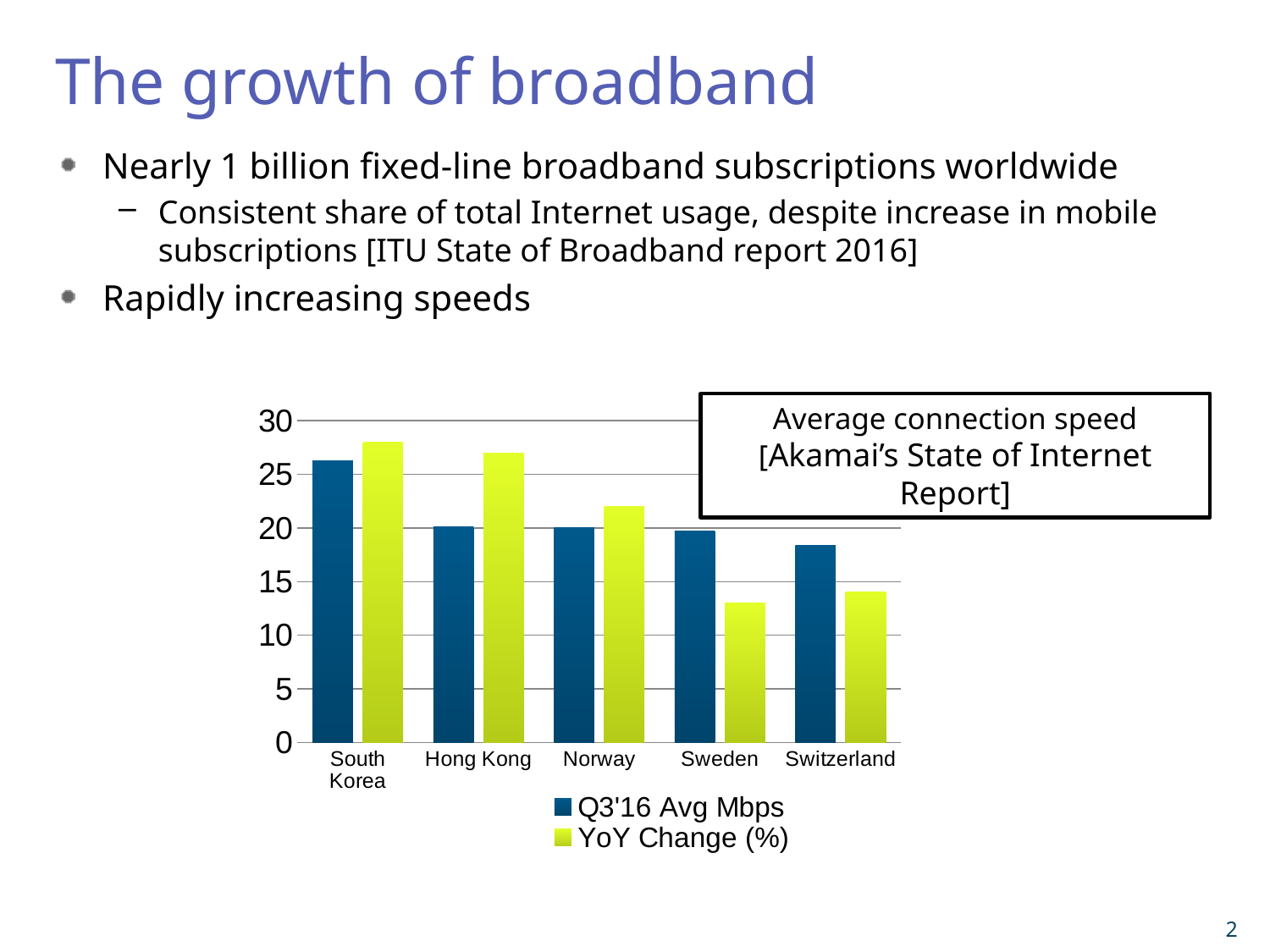
Is the YoY Change (%) value for Hong Kong greater or less than 25? greater What are the two series named in the chart's legend? Q3'16 Avg Mbps and YoY Change (%) Is the Q3'16 Avg Mbps value for South Korea greater or less than 25? greater What is the title shown in the box on the chart? Average connection speed [Akamai's State of Internet Report] Is the YoY Change (%) value for Sweden greater or less than 15? less Do the Q3'16 Avg Mbps values rise or fall from South Korea to Switzerland along the x axis? fall Which country has the lowest Q3'16 Avg Mbps value? Switzerland Which country has the highest Q3'16 Avg Mbps value? South Korea What kind of chart is shown on the slide? Bar chart How many countries are shown on the x axis of the chart? 5 How many series does the chart's legend list? 2 Which is larger, the YoY Change (%) for South Korea or for Sweden? South Korea